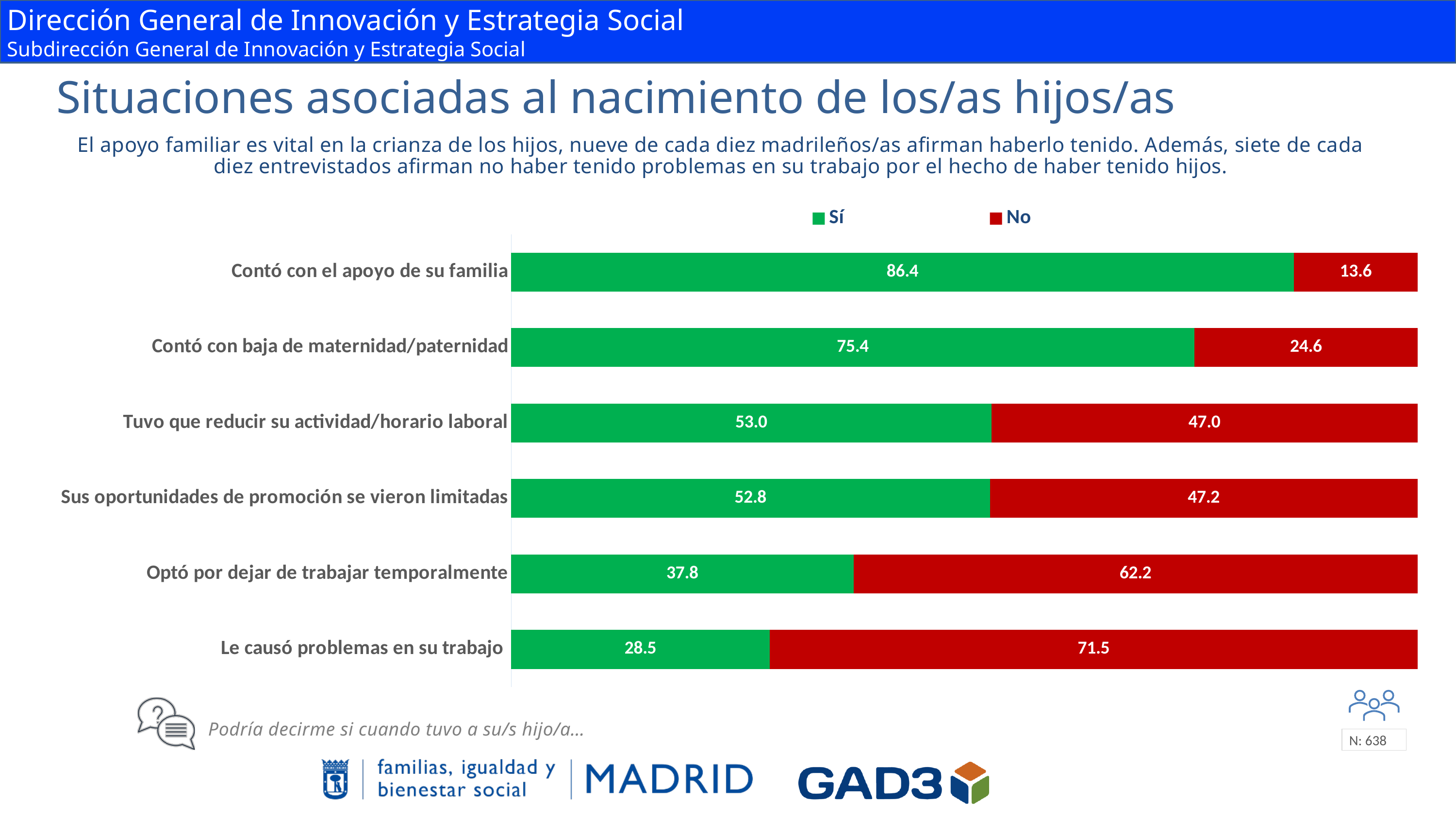
What is the 'Sí' value for 'Le causó problemas en su trabajo'? 28.5 What is the 'No' value for 'Optó por dejar de trabajar temporalmente'? 62.2 What is the 'Sí' value for 'Contó con el apoyo de su familia'? 86.4 Which colour represents the 'No' series in the chart? Red Which category has the highest 'Sí' value? Contó con el apoyo de su familia How many series does the legend list? 2 What kind of chart is shown on the slide? Stacked bar chart Which is larger for 'Tuvo que reducir su actividad/horario laboral': the 'Sí' value or the 'No' value? Sí How many categories are shown in the chart? 6 Which category has the lowest 'Sí' value? Le causó problemas en su trabajo What is the total of the stacked bar for 'Sus oportunidades de promoción se vieron limitadas'? 100.0 What is the difference between the 'Sí' and 'No' values for 'Contó con baja de maternidad/paternidad'? 50.8